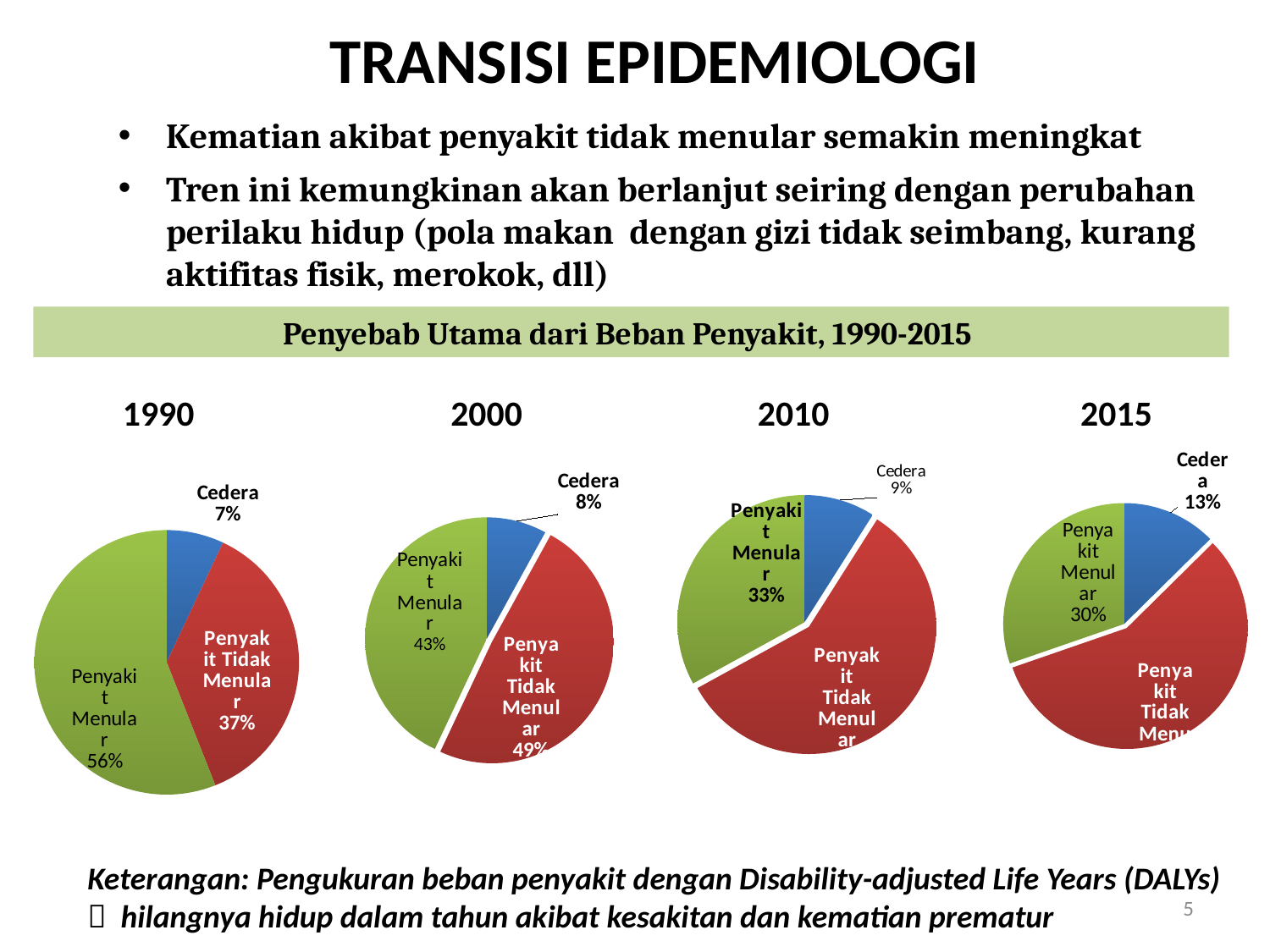
In the 2000 pie chart, which is larger: Penyakit Menular or Penyakit Tidak Menular? Penyakit Tidak Menular In the 1990 pie chart, which category has the largest share? Penyakit Menular In the 2015 pie chart, which category has the largest share? Penyakit Tidak Menular In the 2010 pie chart, which category has the smallest share? Cedera In the 2010 pie chart, what percentage is shown for Penyakit Menular? 33% Across the four pie charts from 1990 to 2015, does the share for Cedera rise or fall? rise In the 2000 pie chart, what percentage is shown for Penyakit Tidak Menular? 49% In the 1990 pie chart, what share of the disease burden is attributed to Cedera? 7% How many pie charts are shown on the slide? 4 In the 1990 pie chart, what is the difference between the shares of Penyakit Menular and Penyakit Tidak Menular? 19% In the 2015 pie chart, what percentage is shown for Cedera? 13% In the 1990 pie chart, what percentage is shown for Penyakit Menular? 56%